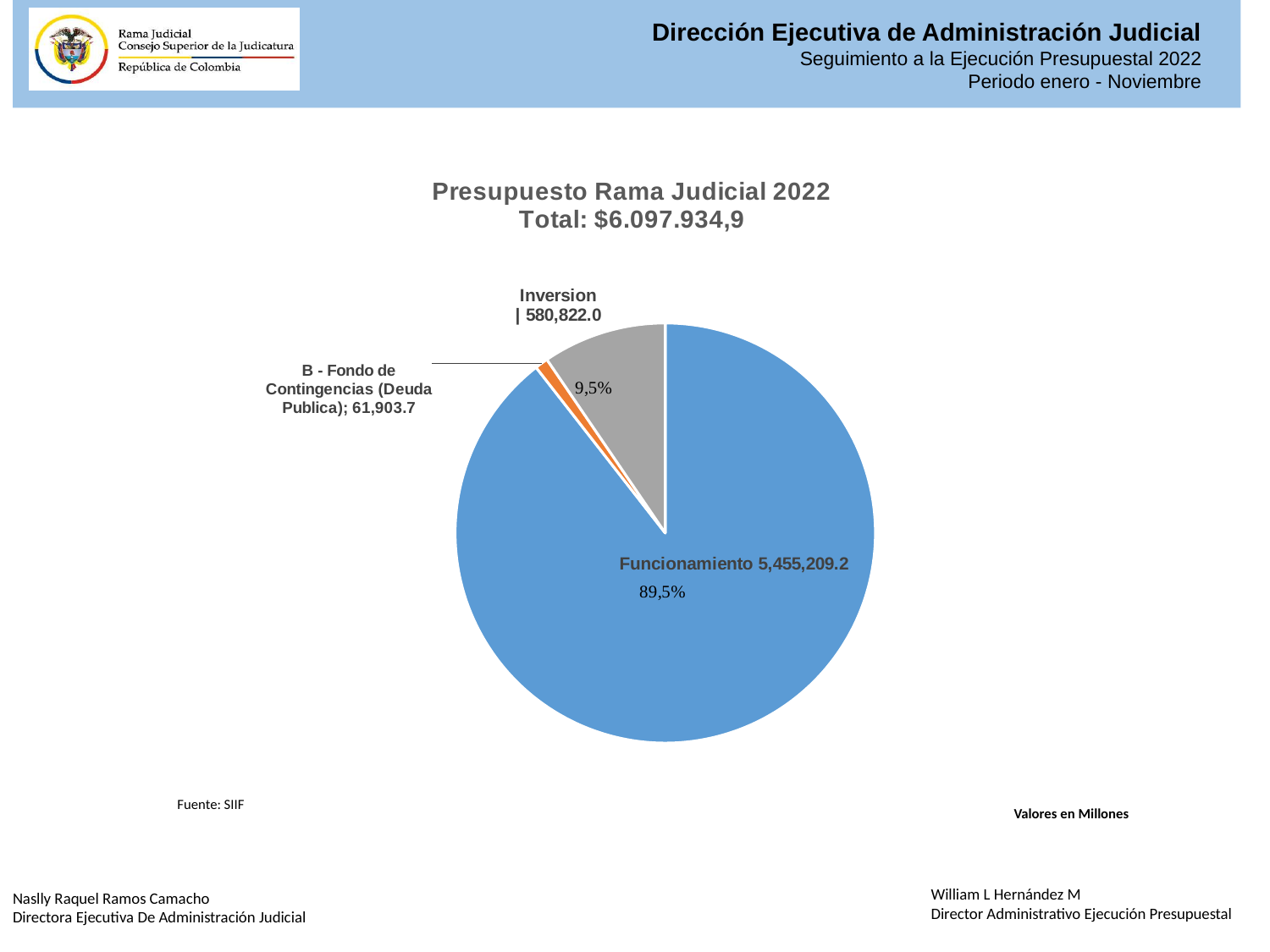
What share of the pie does Inversion represent? 9,5% How many slices does the pie chart have? 3 What is the value for Inversion? 580,822.0 What total is stated in the chart title? $6.097.934,9 Which category has the largest slice of the pie? Funcionamiento What is the value for Funcionamiento? 5,455,209.2 What kind of chart is shown on the slide? Pie chart Which category has the smallest slice of the pie? B - Fondo de Contingencias (Deuda Publica) What share of the pie does Funcionamiento represent? 89,5% What is the value for B - Fondo de Contingencias (Deuda Publica)? 61,903.7 Which is larger, the value for Inversion or the value for B - Fondo de Contingencias (Deuda Publica)? Inversion What is the difference between the values for Funcionamiento and Inversion? 4,874,387.2